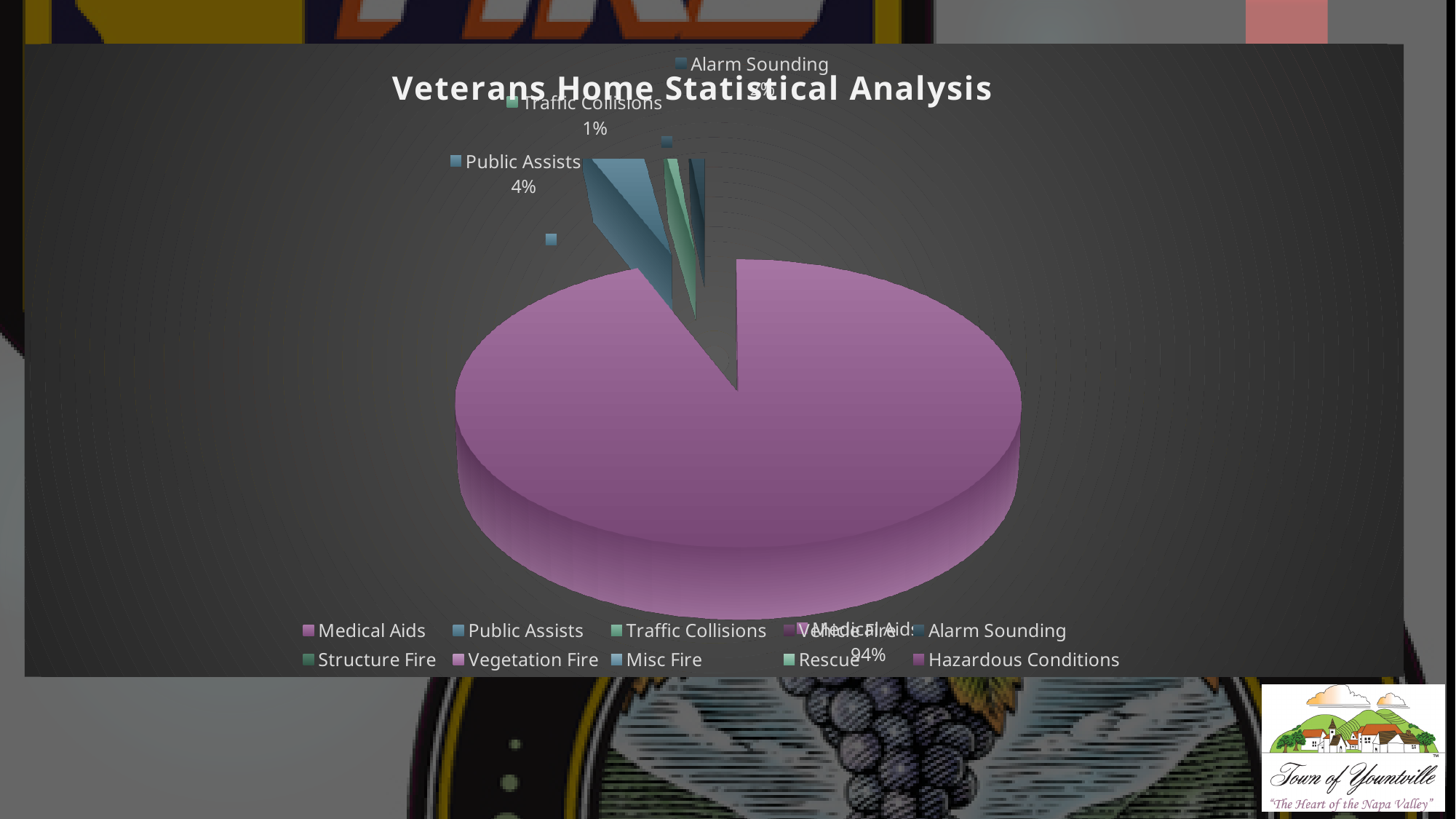
What is the difference in percentage points between Public Assists and Traffic Collisions? 3 Which category has the largest share of the pie? Medical Aids What share of the pie is Medical Aids? 94% Which is larger, Public Assists or Traffic Collisions? Public Assists What is the title of the chart? Veterans Home Statistical Analysis How many categories does the legend list? 10 What is the difference in percentage points between Medical Aids and Public Assists? 90 What kind of chart is shown on the slide? pie chart What percentage is shown for Public Assists? 4% What percentage is shown for Traffic Collisions? 1% Which is larger, Medical Aids or Public Assists? Medical Aids